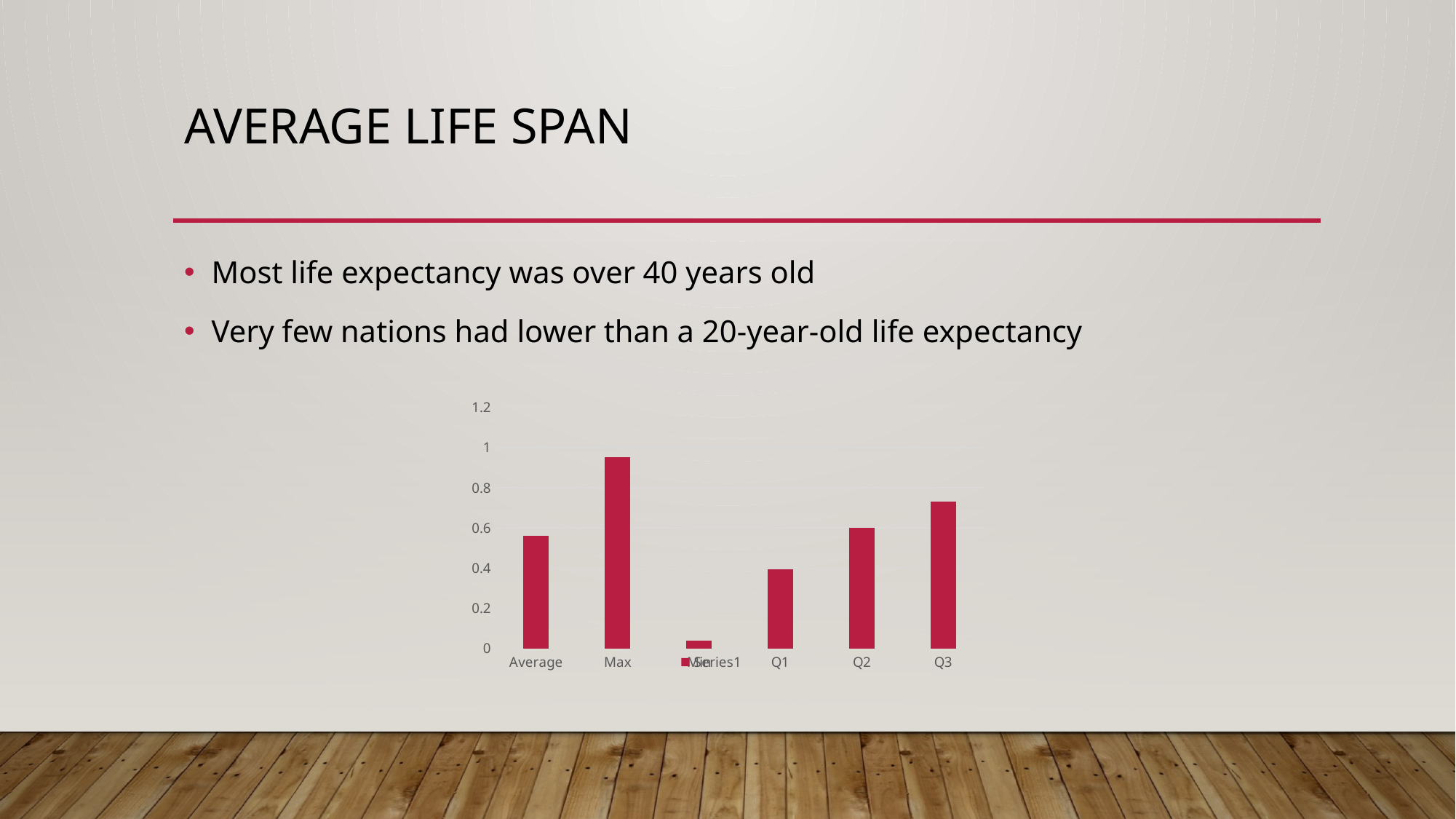
Which is larger, the value for Average or the value for Q1? Average Is the value for Q3 greater or less than 0.6? greater Is the value for Average greater or less than 0.4? greater Which category has the lowest bar on the chart? Min What is the name of the series shown in the chart legend? Series1 Is the value for Max greater or less than 0.8? greater How many series does the chart legend list? 1 What kind of chart is shown on the slide? bar chart Which is larger, the value for Q3 or the value for Q2? Q3 Which category has the highest bar on the chart? Max How many categories are plotted on the chart? 6